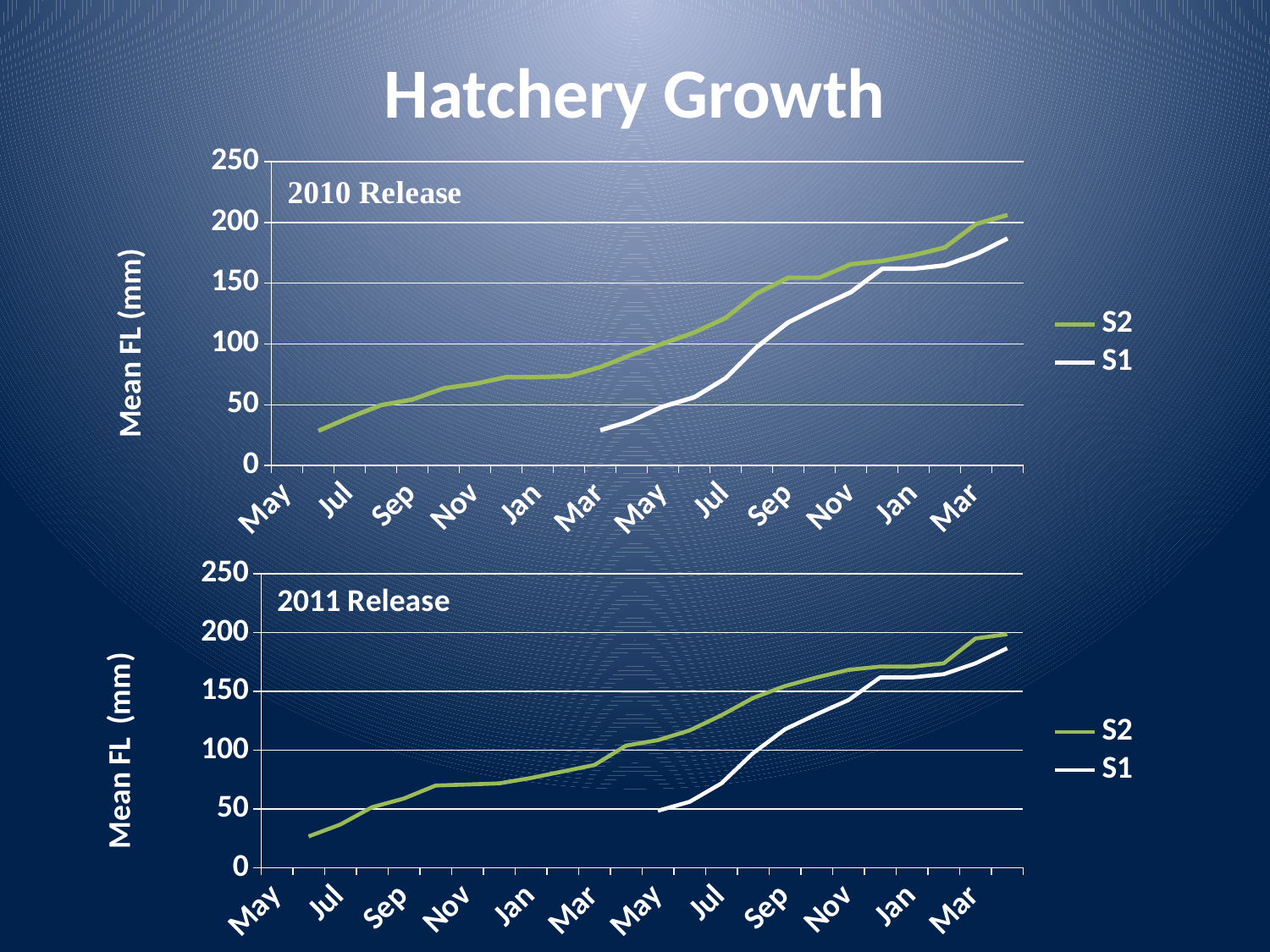
In the 2011 Release chart, do the S1 values rise or fall from left to right along the x axis? rise In the 2010 Release chart, is the final value of S2 (at the last Mar) greater or less than 200? greater In the 2010 Release chart, do the S2 values rise or fall from left to right along the x axis? rise In the 2010 Release chart, is the final value of S1 (at the last Mar) greater or less than 200? less In the 2011 Release chart, is the final value of S1 (at the last Mar) greater or less than 200? less How many month labels are shown on the x axis of the 2010 Release chart? 12 What is the y-axis label of the 2011 Release chart? Mean FL (mm) How many series does the legend of the 2011 Release chart list? 2 In the 2011 Release chart, which series has the larger value at the second Sep, S2 or S1? S2 In the 2010 Release chart, which series has the larger value at the second Nov, S2 or S1? S2 What kind of chart is the 2010 Release chart? line chart